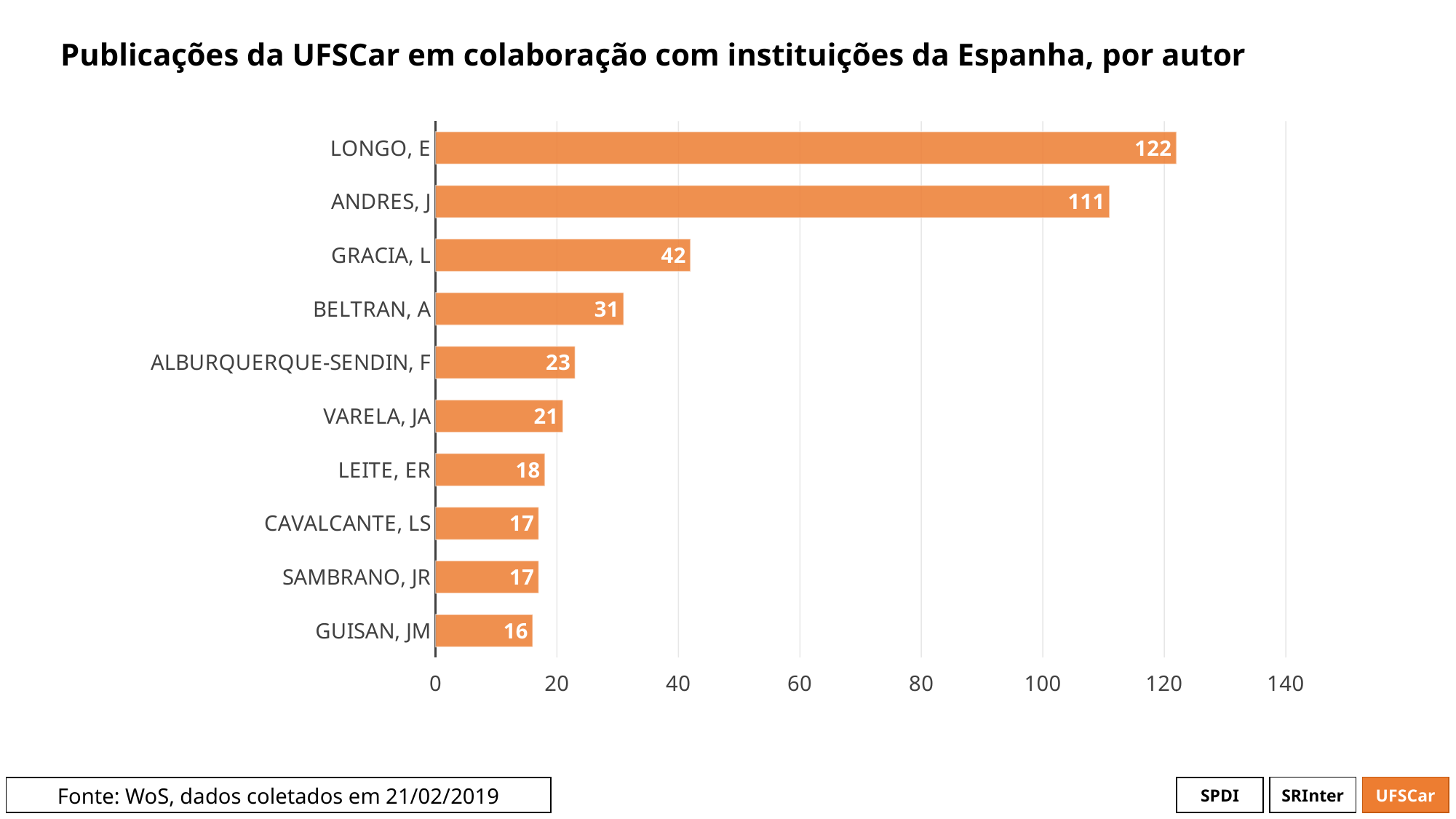
What is the difference between the values for GRACIA, L and BELTRAN, A? 11 Which is larger, the value for VARELA, JA or the value for LEITE, ER? VARELA, JA Which author has the lowest number of publications? GUISAN, JM How many authors are shown in the chart? 10 What is the value shown for ALBURQUERQUE-SENDIN, F? 23 What kind of chart is shown on the slide? bar chart What is the difference between the values for LONGO, E and ANDRES, J? 11 Is the value for ANDRES, J greater or less than 100? greater What is the title of the chart? Publicações da UFSCar em colaboração com instituições da Espanha, por autor What is the value shown for GRACIA, L? 42 Which author has the highest number of publications? LONGO, E How many publications does LONGO, E have? 122